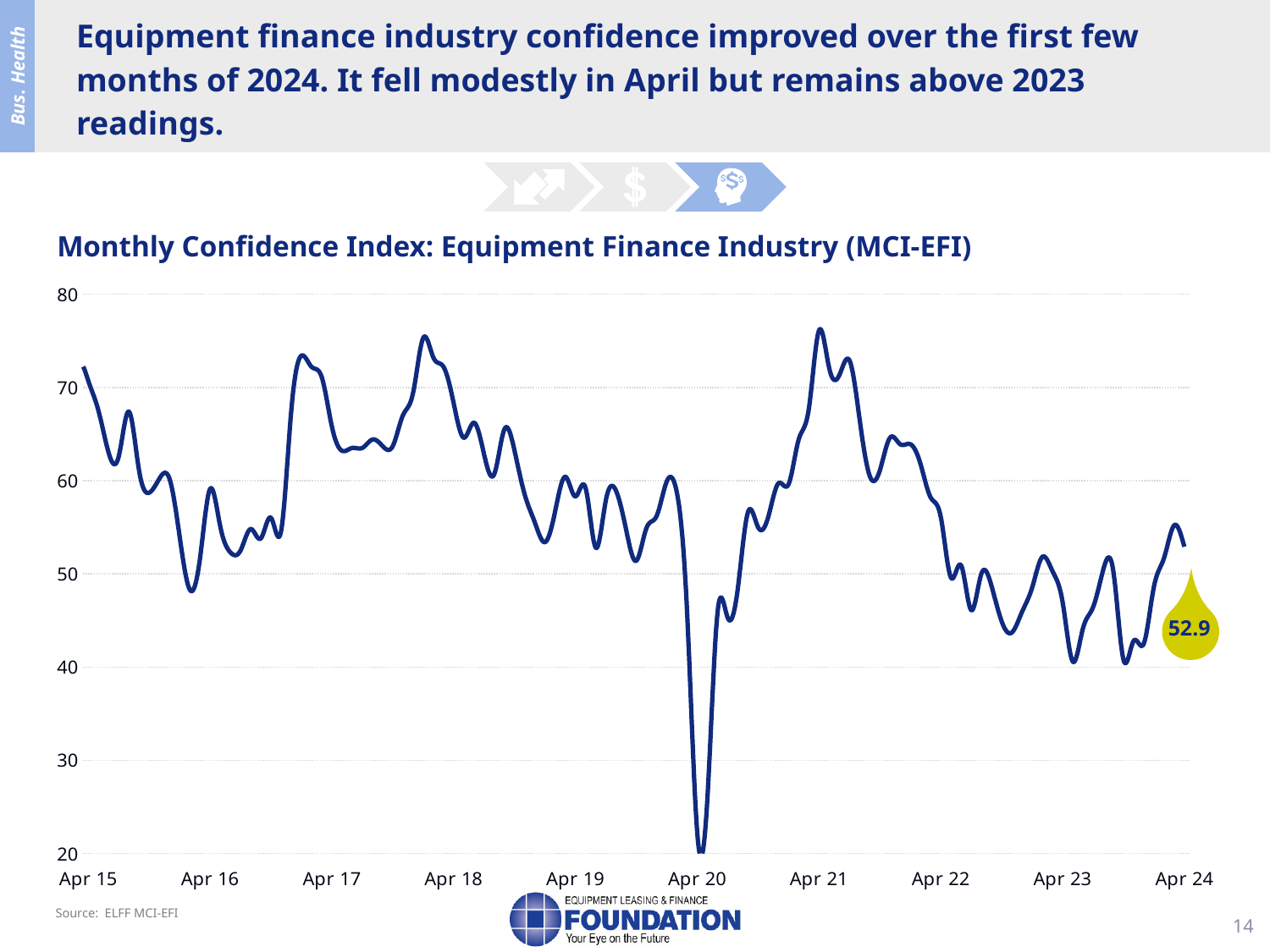
Around which x-axis label does the index reach its lowest point? Apr 20 Is the value of the index at Apr 17 greater or less than 60? greater Is the value of the index at Apr 15 greater or less than 70? greater What is the source cited for the chart? ELFF MCI-EFI Is the lowest point of the index, near Apr 20, greater or less than 30? less Which is larger: the index value at Apr 15 or at Apr 24? Apr 15 How many year labels are shown on the x axis? 10 What is the value of the Monthly Confidence Index at Apr 24, as labeled on the chart? 52.9 What kind of chart is used to show the Monthly Confidence Index? Line chart Does the index rise or fall between Apr 21 and Apr 22? Fall What is the title of the chart? Monthly Confidence Index: Equipment Finance Industry (MCI-EFI)